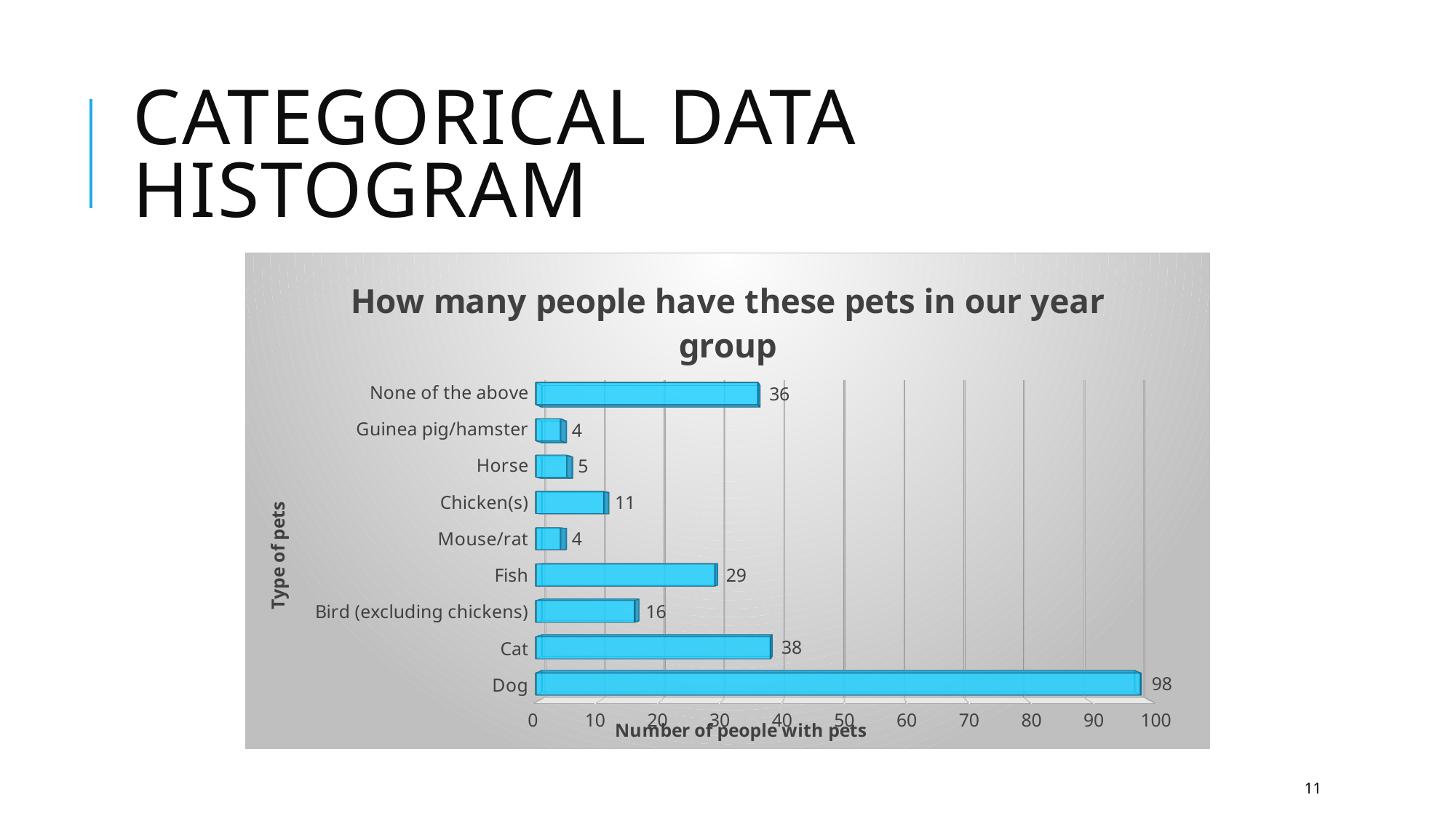
How many categories of pets are shown on the chart? 9 Which is larger, the value for Chicken(s) or the value for Horse? Chicken(s) What kind of chart is shown on the slide? Bar chart Which type of pet has the highest number of people? Dog What is the value for Fish? 29 How many people have a dog according to the chart? 98 Which is larger, the value for Cat or the value for None of the above? Cat What is the difference between the values for Dog and Cat? 60 What is the difference between the values for None of the above and Fish? 7 What is the value for Bird (excluding chickens)? 16 Is the value for Dog greater or less than 90? greater What is the title of the chart? How many people have these pets in our year group